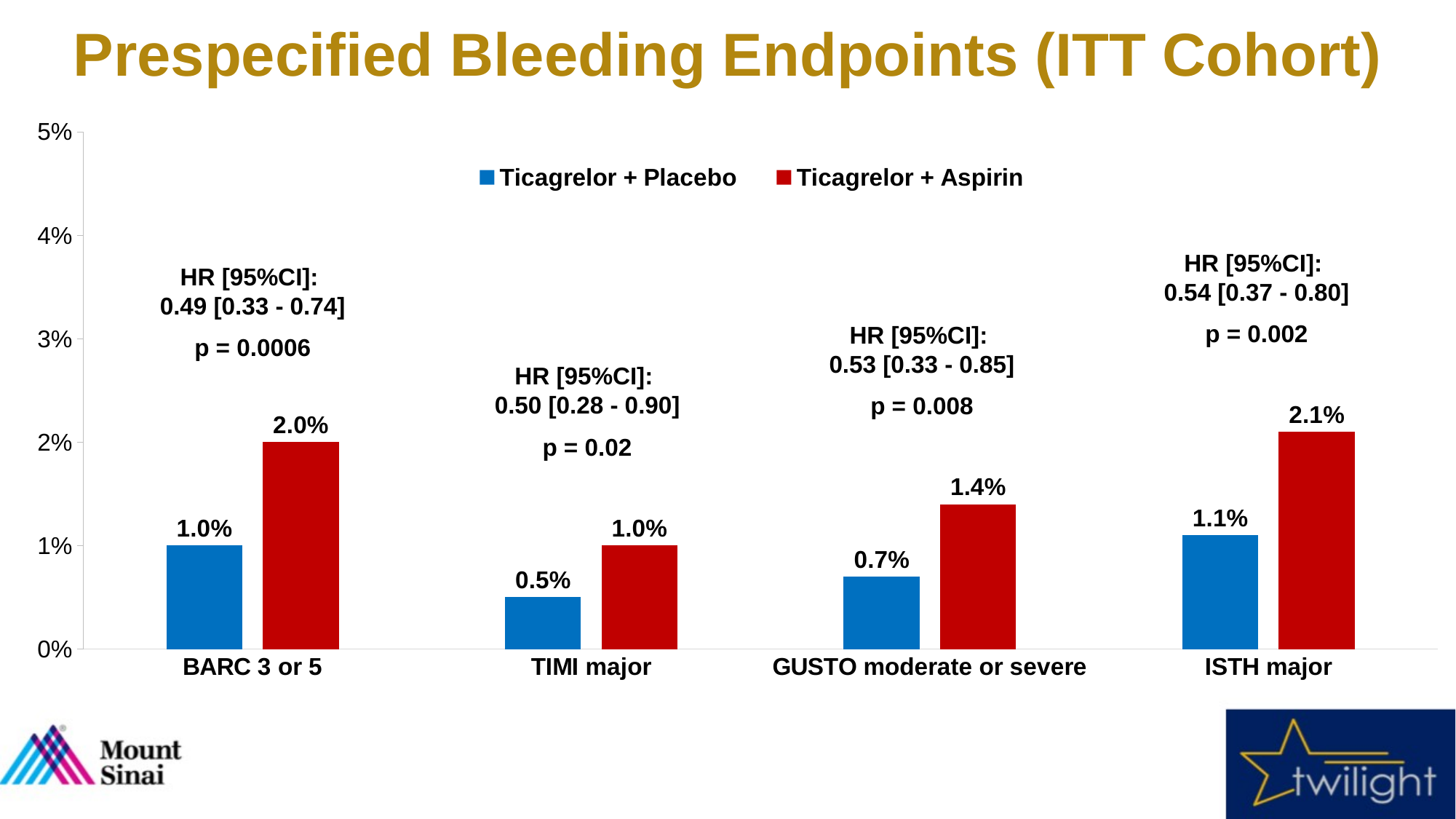
What kind of chart is shown on the slide? Bar chart How many series does the legend list? 2 What is the difference between Ticagrelor + Aspirin and Ticagrelor + Placebo in the GUSTO moderate or severe category? 0.7% Which category has the lowest value for Ticagrelor + Placebo? TIMI major What is the value for Ticagrelor + Aspirin in the BARC 3 or 5 category? 2.0% How many categories are shown on the x axis? 4 Which category has the highest value for Ticagrelor + Aspirin? ISTH major What is the value for Ticagrelor + Aspirin in the ISTH major category? 2.1% What is the value for Ticagrelor + Placebo in the GUSTO moderate or severe category? 0.7% What is the value for Ticagrelor + Placebo in the TIMI major category? 0.5% Which is larger in the ISTH major category: Ticagrelor + Placebo or Ticagrelor + Aspirin? Ticagrelor + Aspirin What is the p value shown for the BARC 3 or 5 category? p = 0.0006